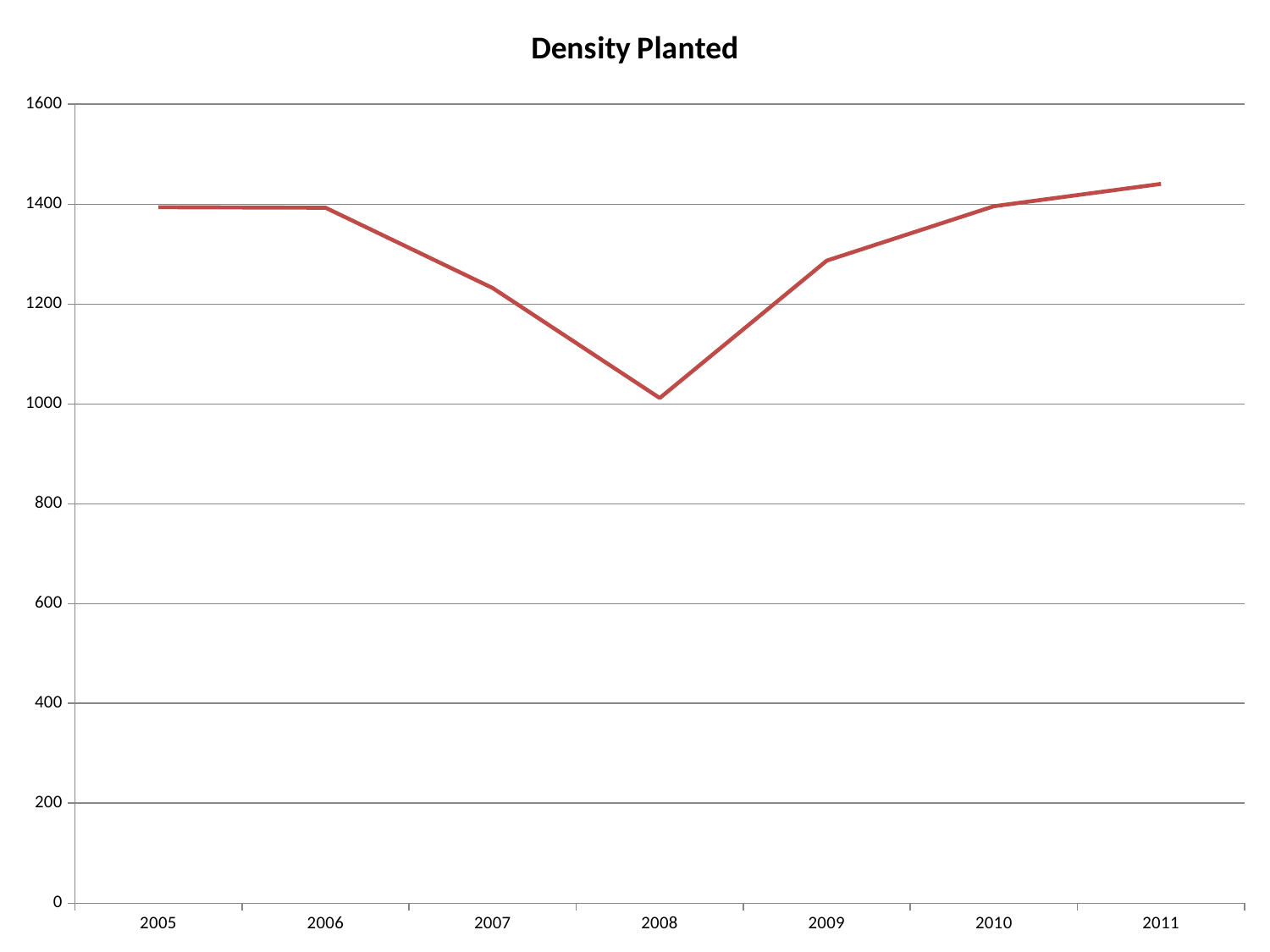
Is the value for 2009 greater or less than 1400? less Which is larger, the value for 2006 or the value for 2007? 2006 Which year has the highest density planted? 2011 What is the title of the chart? Density Planted What kind of chart is shown on the slide? line chart Which is larger, the value for 2008 or the value for 2010? 2010 Which year has the lowest density planted? 2008 Is the value for 2008 greater or less than 1200? less Do the values rise or fall from 2008 to 2011? rise Is the value for 2011 greater or less than 1400? greater How many years are plotted on the x axis? 7